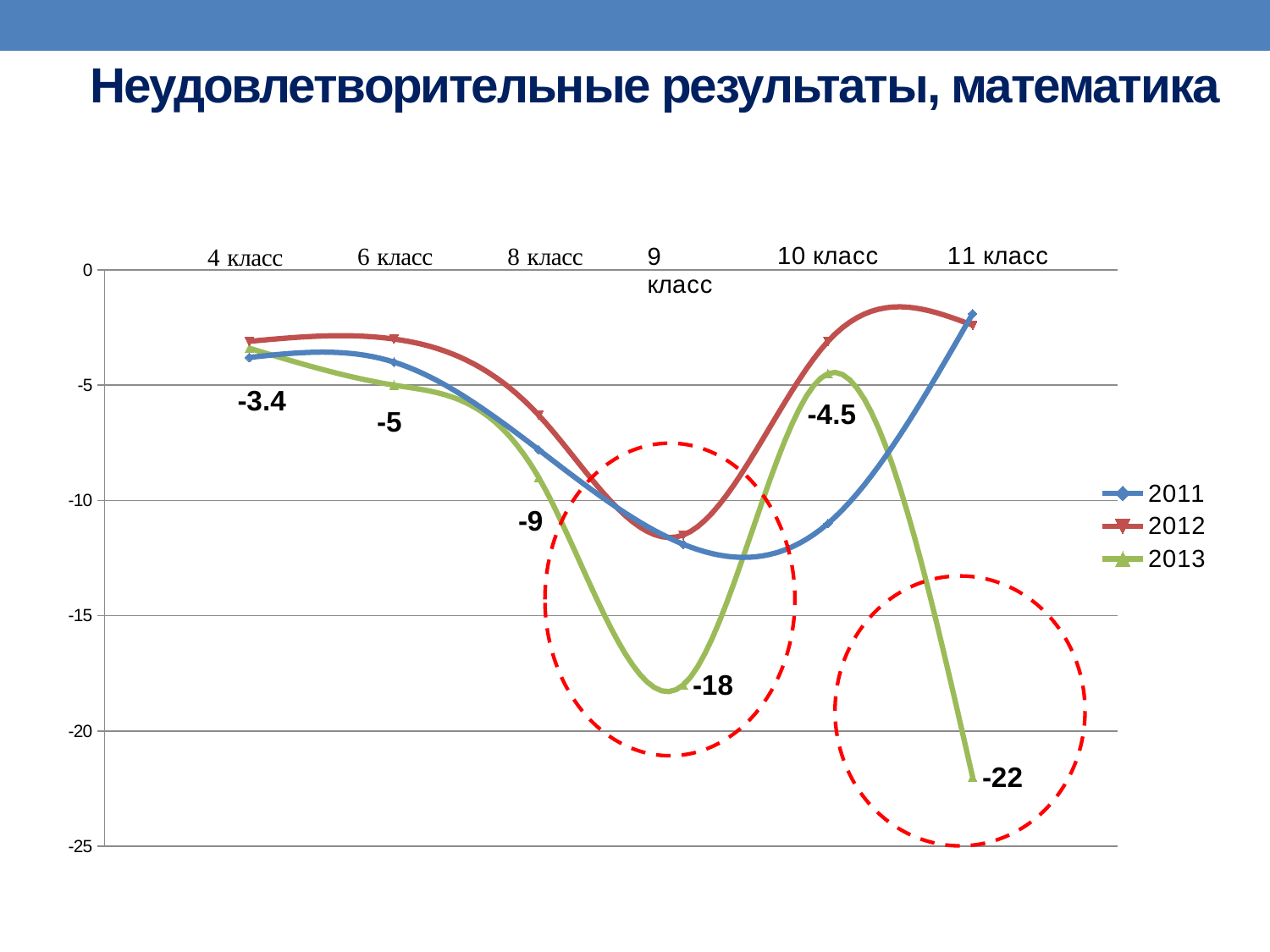
What is the value for the 2013 series at 11 класс? -22 For the 2013 series, which class has the lowest value? 11 класс What is the value for the 2013 series at 10 класс? -4.5 How many class categories are shown on the x axis? 6 Is the value for the 2012 series at 8 класс greater or less than -5? less What is the value for the 2013 series at 4 класс? -3.4 For the 2013 series, which class has the highest value? 4 класс What type of chart is shown on the slide? line chart What is the title of the chart slide? Неудовлетворительные результаты, математика What is the difference between the 2013 values at 9 класс and 10 класс? 13.5 What is the value for the 2013 series at 9 класс? -18 How many series does the legend list? 3